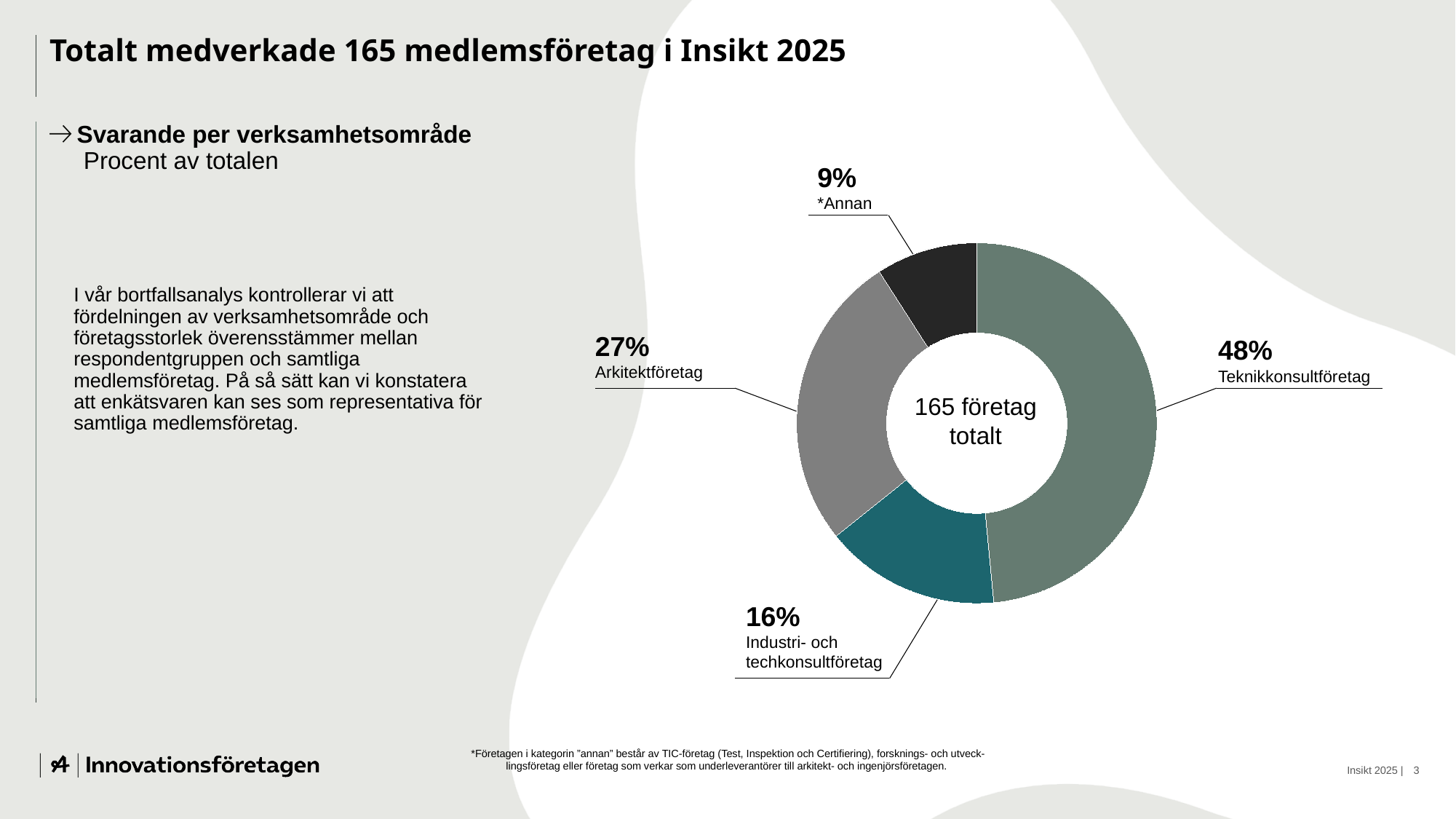
What text is shown in the centre of the doughnut chart? 165 företag totalt What share of the total do Teknikkonsultföretag represent? 48% What is the combined share of Arkitektföretag and *Annan? 36% Which category has the smallest share of the chart? *Annan What kind of chart is shown on the slide? Doughnut (pie) chart What is the difference in percentage points between Teknikkonsultföretag and Arkitektföretag? 21 percentage points What share of the total do Arkitektföretag represent? 27% Which category has the largest share of the chart? Teknikkonsultföretag Which has a larger share, Arkitektföretag or Industri- och techkonsultföretag? Arkitektföretag How many categories are shown in the chart? 4 What share of the total does the *Annan category represent? 9% What share of the total do Industri- och techkonsultföretag represent? 16%